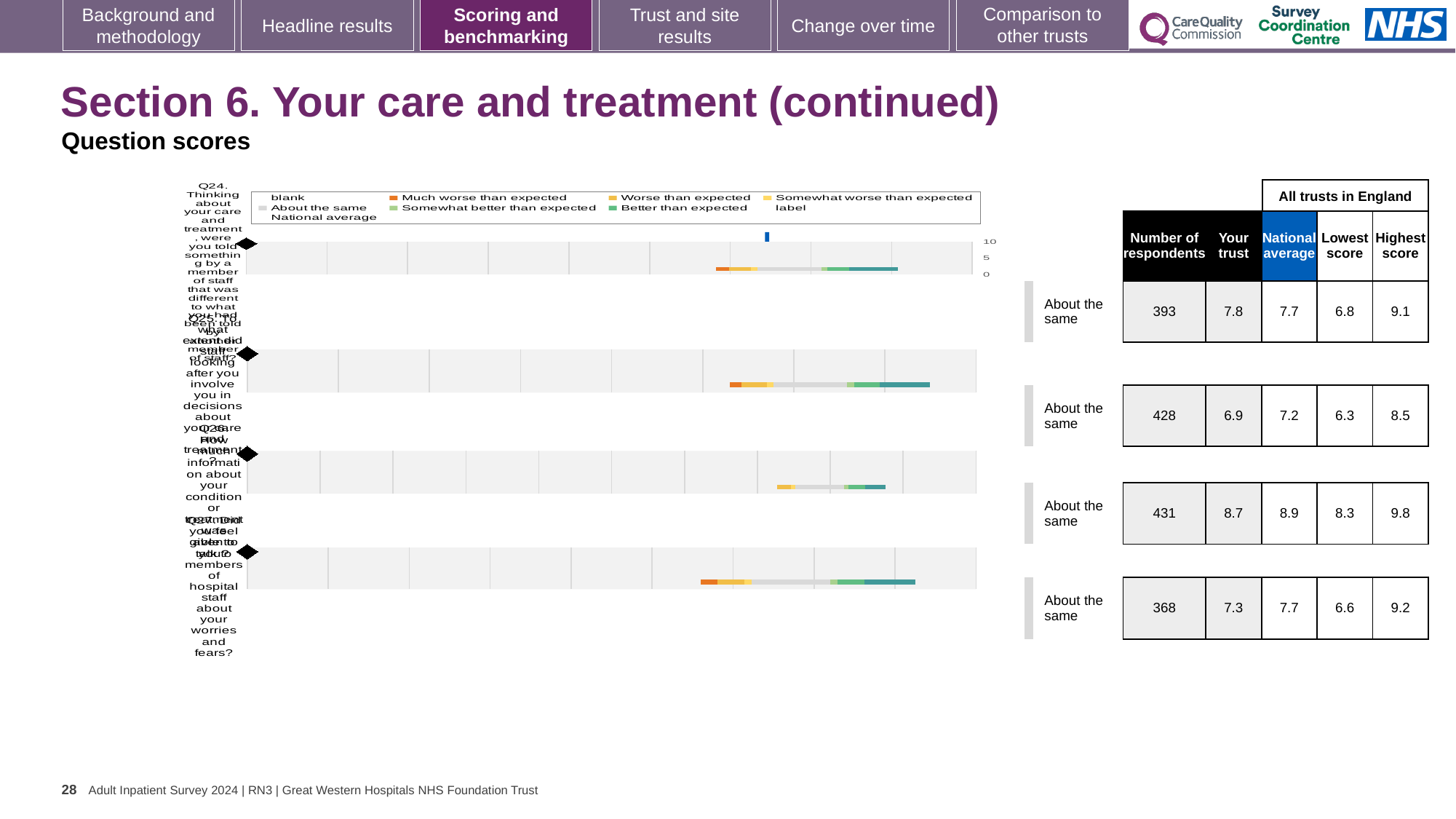
For Q25 (the second chart), what is the national average score? 7.2 Which question has the highest 'Your trust' score? Q26 In the legend, what colour represents 'Much worse than expected'? Orange For Q27 (the bottom chart), how many respondents are listed? 368 For Q24, what is the difference between the highest score and the lowest score? 2.3 Which question has the lowest 'Your trust' score? Q25 For Q24 (the top chart), what is the 'Your trust' score shown in the table? 7.8 For Q26 (the third chart), what is the highest score among all trusts in England? 9.8 What kind of chart is used for each question on the slide? bar chart What benchmark category label is shown next to each of the four question charts? About the same For Q26, which is larger: the 'Your trust' score or the national average? National average How many question charts are shown on the slide? 4